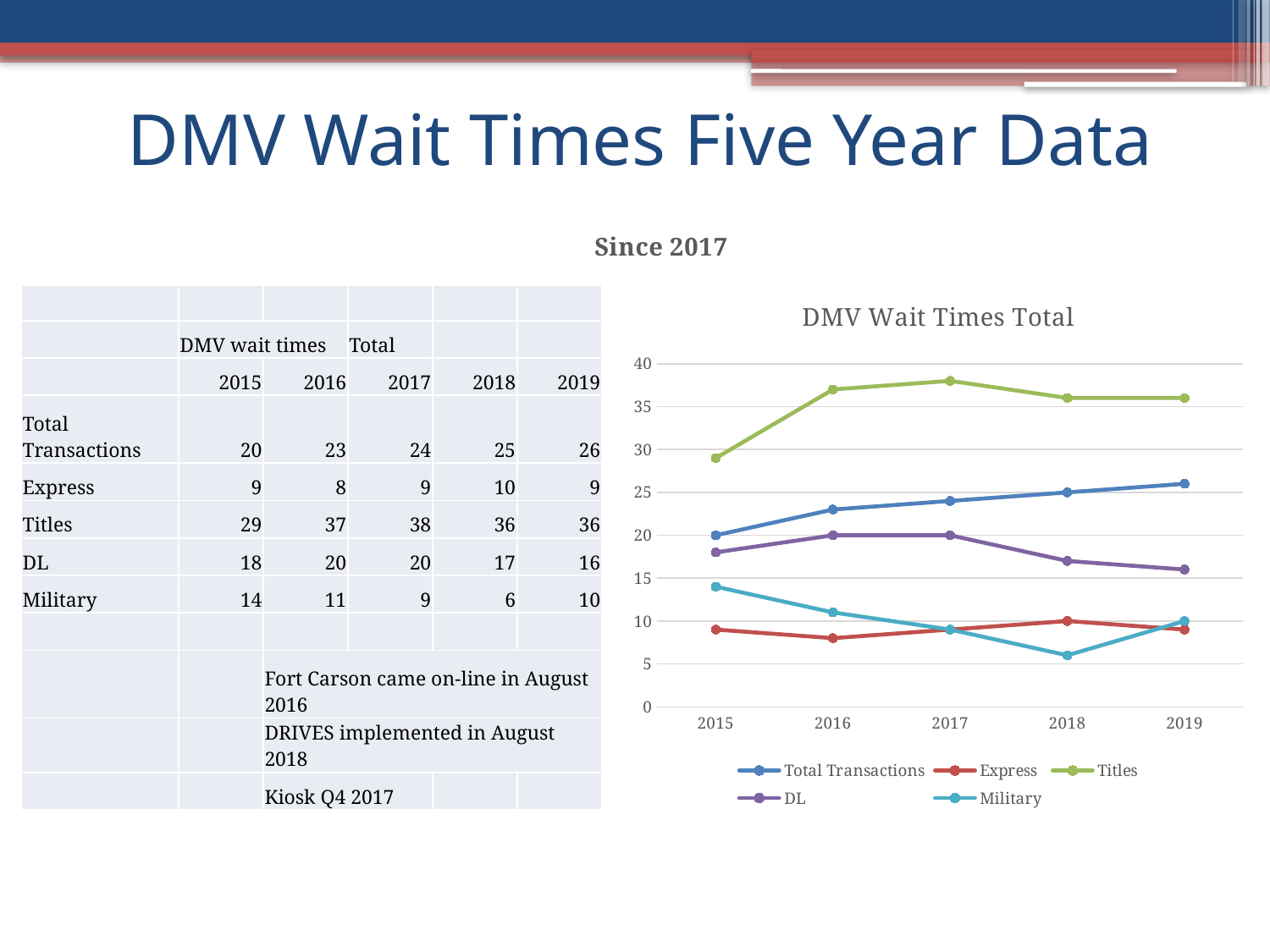
What is the Total Transactions value for 2019? 26 What is the title of the chart? DMV Wait Times Total What kind of chart is shown on the slide? line chart How many series does the chart legend list? 5 Which is larger in 2019, the DL value or the Military value? DL What is the difference between the Titles value and the DL value in 2015? 11 Which series has the highest value in 2016? Titles Which series has the lowest value in 2018? Military What is the Military value for 2018? 6 What is the Titles value for 2017? 38 Do the Total Transactions values rise or fall from 2015 to 2019? rise How many years are plotted along the x axis of the chart? 5